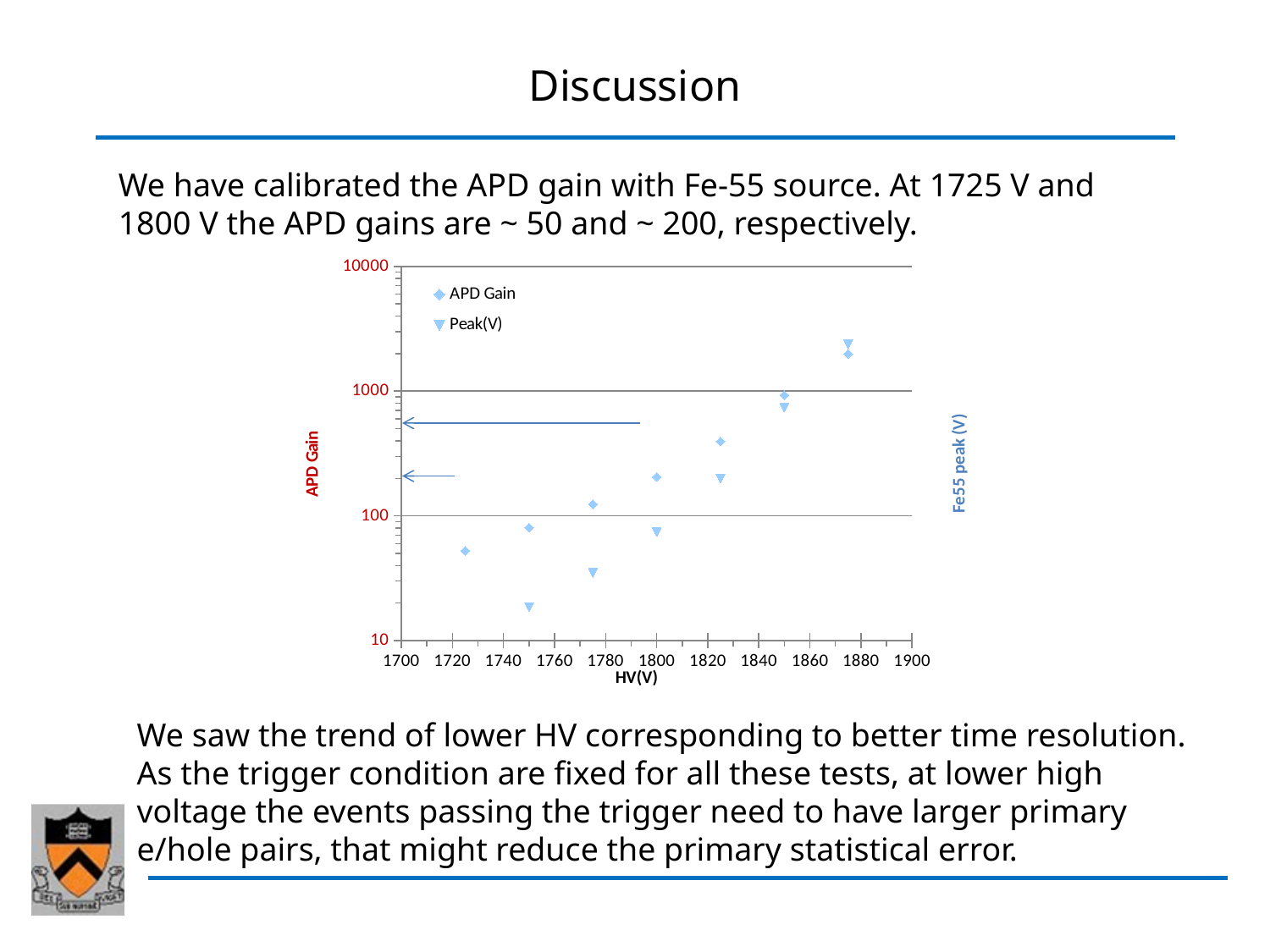
Do the APD Gain values rise or fall as HV increases along the x axis? Rise How many series does the chart legend list? 2 Is the Peak(V) value at 1750 V greater or less than 100? less What is the title of the x axis of the chart? HV(V) What kind of chart is shown on the slide? Scatter chart How many Peak(V) points are plotted on the chart? 6 Is the APD Gain value at 1875 V greater or less than 1000? greater At which HV value is the APD Gain highest? 1875 Is the APD Gain value at 1725 V greater or less than 100? less How many APD Gain points are plotted on the chart? 7 At 1750 V, which is larger: the APD Gain value or the Peak(V) value? APD Gain